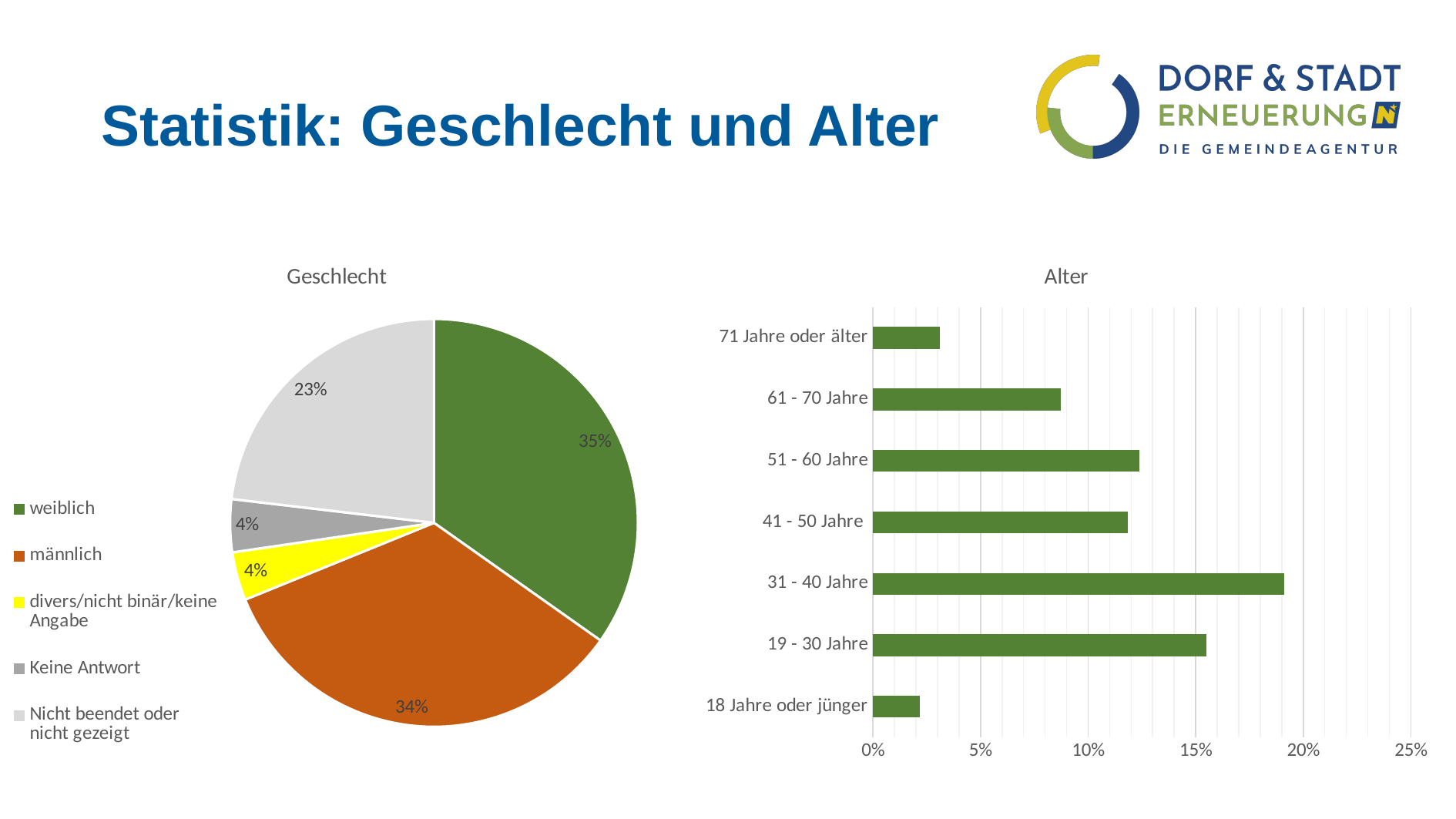
How many legend entries does the Geschlecht pie chart list? 5 In the Alter chart, which is larger, the bar for 31 - 40 Jahre or the bar for 19 - 30 Jahre? 31 - 40 Jahre What kind of chart is the Alter chart? bar chart In the Geschlecht pie chart, which category has the largest slice? weiblich In the Geschlecht pie chart, what is the difference between the weiblich and männlich slices? 1% In the Alter chart, is the value for 31 - 40 Jahre greater or less than 15%? greater In the Geschlecht pie chart, what percentage is shown for weiblich? 35% How many age groups are shown in the Alter chart? 7 In the Alter chart, which age group has the longest bar? 31 - 40 Jahre In the Geschlecht pie chart, what percentage is shown for männlich? 34% In the Alter chart, is the value for 61 - 70 Jahre greater or less than 10%? less In the Geschlecht pie chart, what percentage is shown for Nicht beendet oder nicht gezeigt? 23%